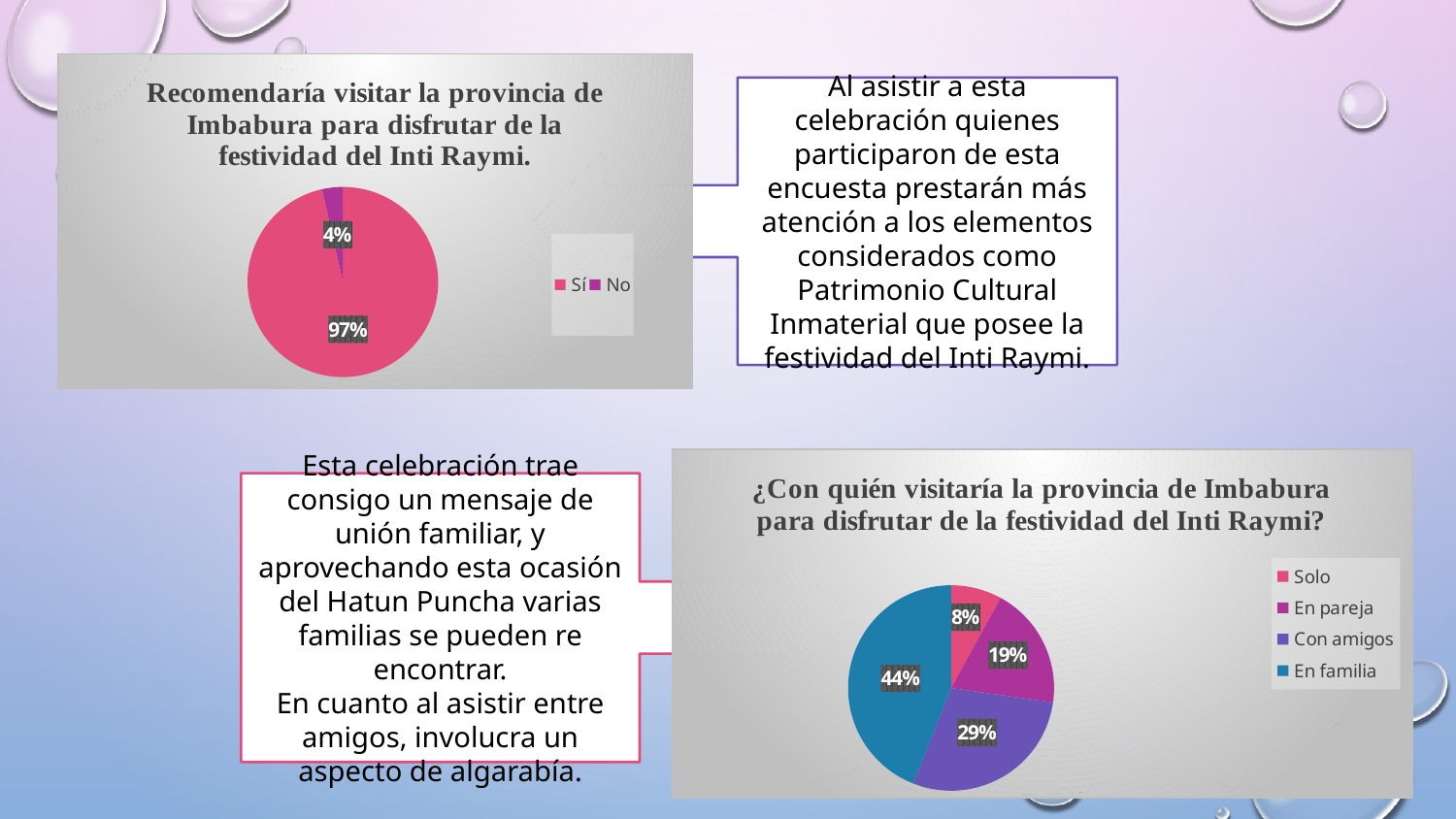
In the bottom-right chart titled "¿Con quién visitaría la provincia de Imbabura...?", which category has the smallest share? Solo In the bottom-right chart titled "¿Con quién visitaría la provincia de Imbabura...?", how many categories does the legend list? 4 In the bottom-right chart titled "¿Con quién visitaría la provincia de Imbabura...?", what percentage is shown for Solo? 8% What kind of chart is the top-left chart titled "Recomendaría visitar la provincia de Imbabura..."? Pie chart In the top-left chart titled "Recomendaría visitar la provincia de Imbabura...", what percentage answered Sí? 97% In the bottom-right chart titled "¿Con quién visitaría la provincia de Imbabura...?", which is larger, Con amigos or En pareja? Con amigos In the bottom-right chart titled "¿Con quién visitaría la provincia de Imbabura...?", what is the difference in percentage points between En familia and En pareja? 25 In the bottom-right chart titled "¿Con quién visitaría la provincia de Imbabura...?", what percentage is shown for En familia? 44% In the top-left chart titled "Recomendaría visitar la provincia de Imbabura...", what percentage answered No? 4% In the bottom-right chart titled "¿Con quién visitaría la provincia de Imbabura...?", what percentage is shown for Con amigos? 29% In the top-left chart titled "Recomendaría visitar la provincia de Imbabura...", which response has the largest share? Sí In the top-left chart titled "Recomendaría visitar la provincia de Imbabura...", how many entries does the legend list? 2